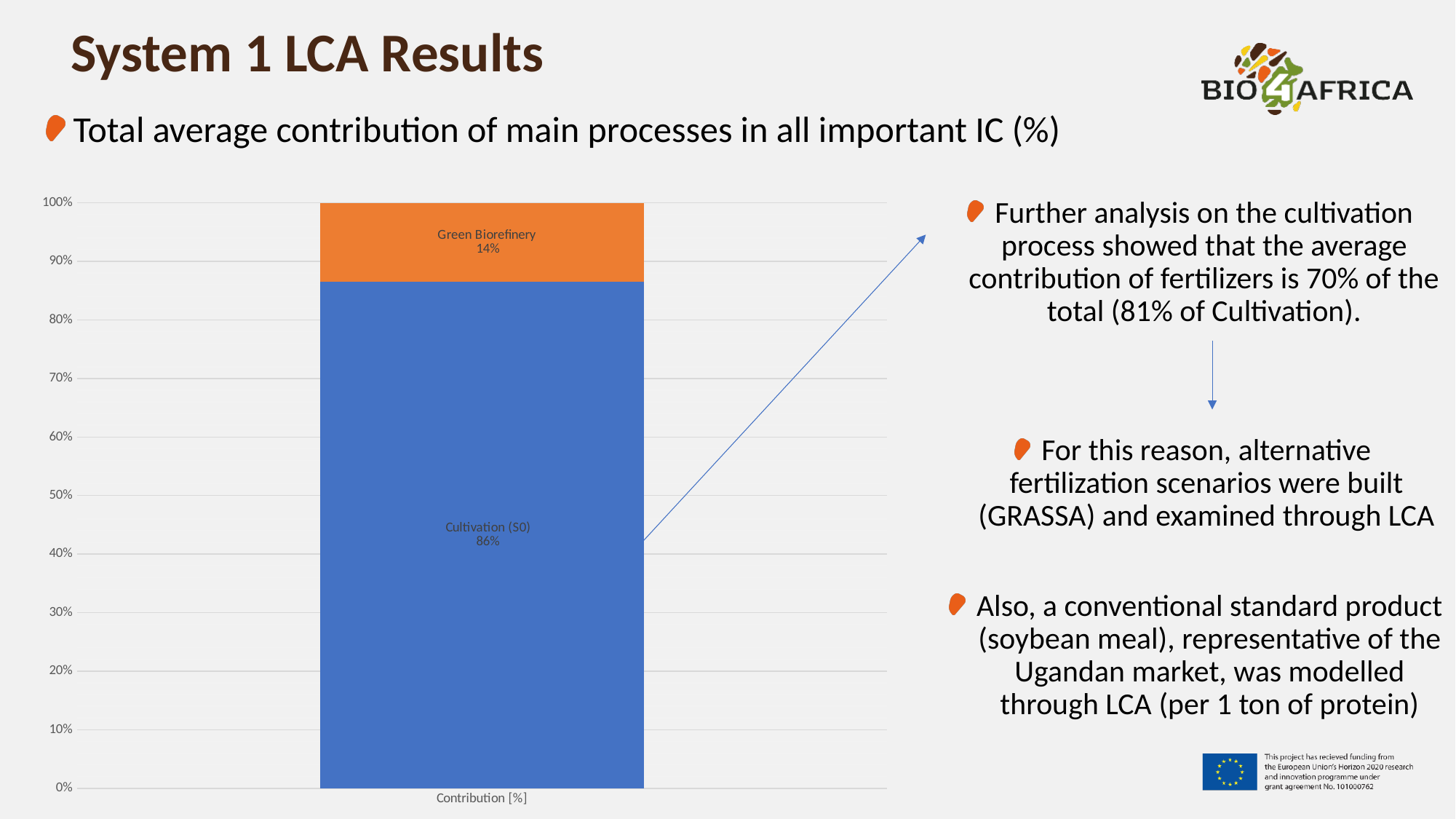
What is the label on the x axis of the chart? Contribution [%] Which segment is shown in orange? Green Biorefinery Is the value for Cultivation (S0) greater or less than 80%? greater Which segment of the bar is larger, Cultivation (S0) or Green Biorefinery? Cultivation (S0) How many segments make up the stacked bar? 2 Which segment has the smallest value? Green Biorefinery What kind of chart is shown on the slide? Stacked bar chart Is the value for Green Biorefinery greater or less than 20%? less What is the value for Cultivation (S0) in the stacked bar? 86% What is the difference between the Cultivation (S0) and Green Biorefinery values? 72% What is the value for Green Biorefinery in the stacked bar? 14% What is the total of the stacked bar? 100%